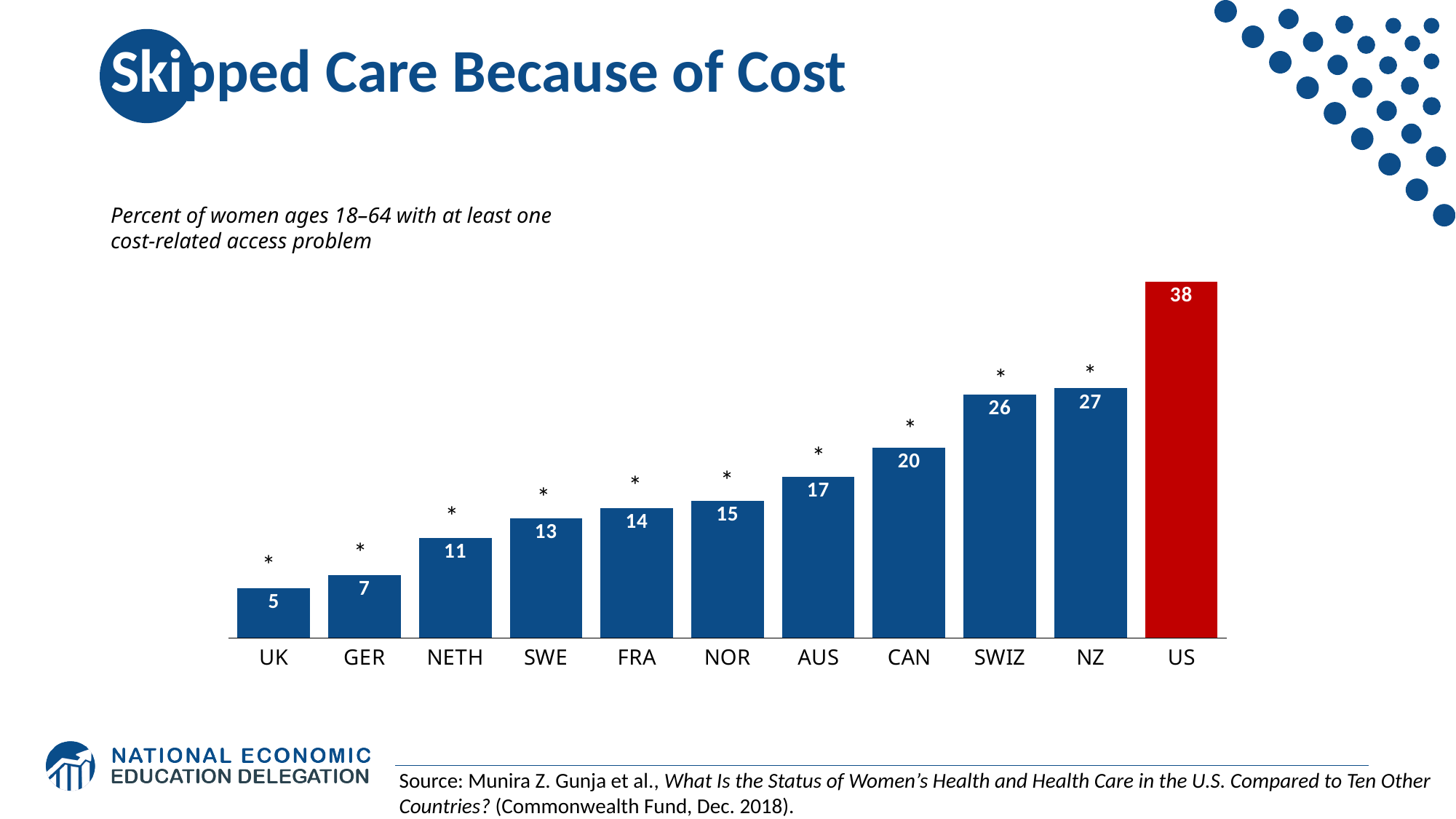
Which country has the highest value? US What is the value for the US? 38 Which has a larger value, AUS or NOR? AUS What kind of chart is shown on the slide? Bar chart Which bar is coloured red rather than blue? US What is the value for Canada (CAN)? 20 Do the values rise or fall from left to right across the countries? Rise How many countries are shown in the chart? 11 What is the difference between the values for SWE and UK? 8 What is the difference between the values for the US and NZ? 11 Which country has the lowest value? UK What is the value for Germany (GER)? 7